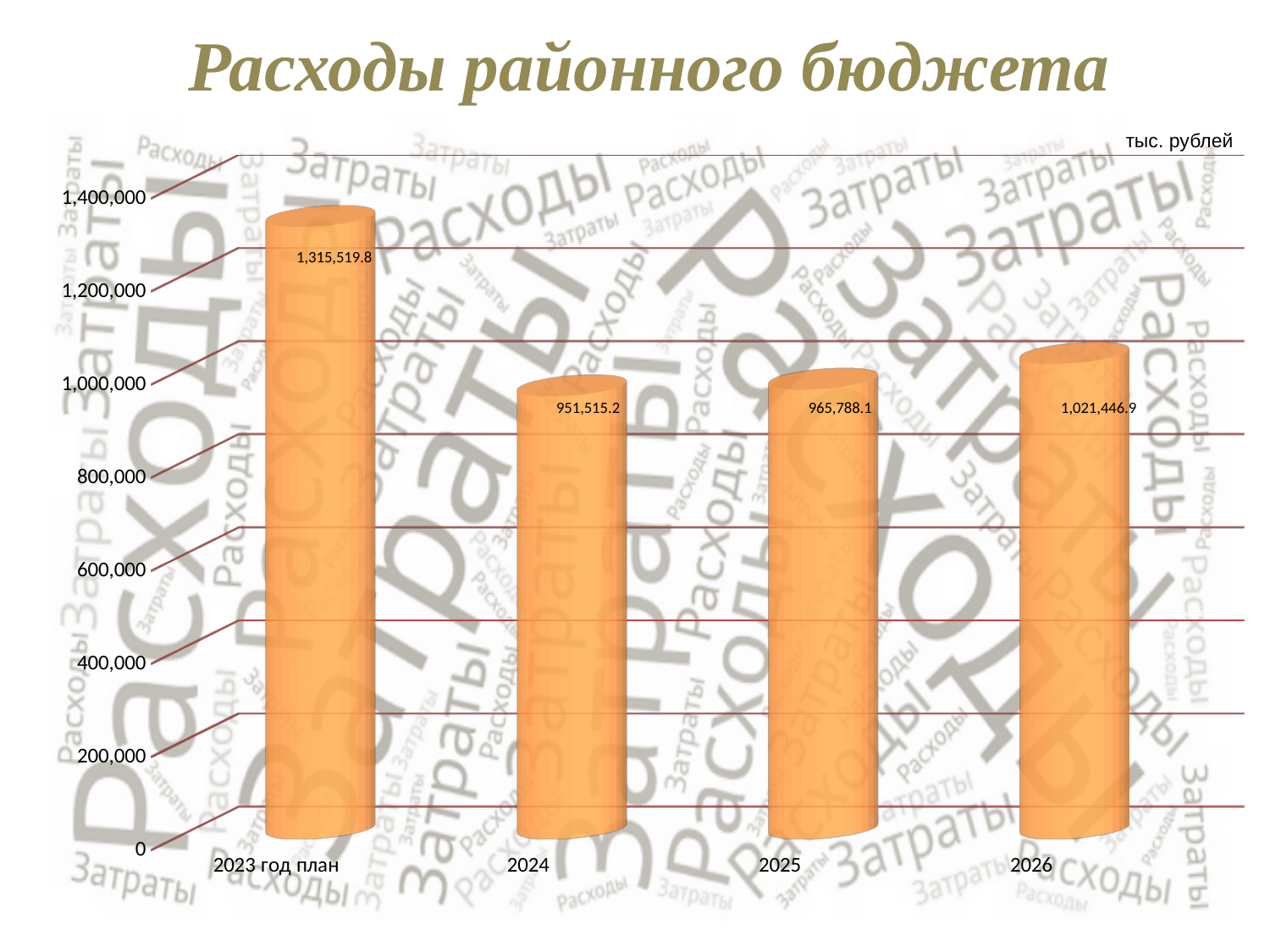
Which category has the highest value? 2023 год план What is the value for 2025? 965,788.1 What is the value for 2026? 1,021,446.9 Which is larger, the value for 2024 or the value for 2025? 2025 What kind of chart is shown on the slide? bar chart What is the difference between the values for 2026 and 2025? 55,658.8 What is the value for 2023 год план? 1,315,519.8 How many categories are shown on the x axis? 4 What is the value for 2024? 951,515.2 Which category has the lowest value? 2024 What is the difference between the values for 2023 год план and 2024? 364,004.6 Is the value for 2026 greater or less than 1,000,000? greater